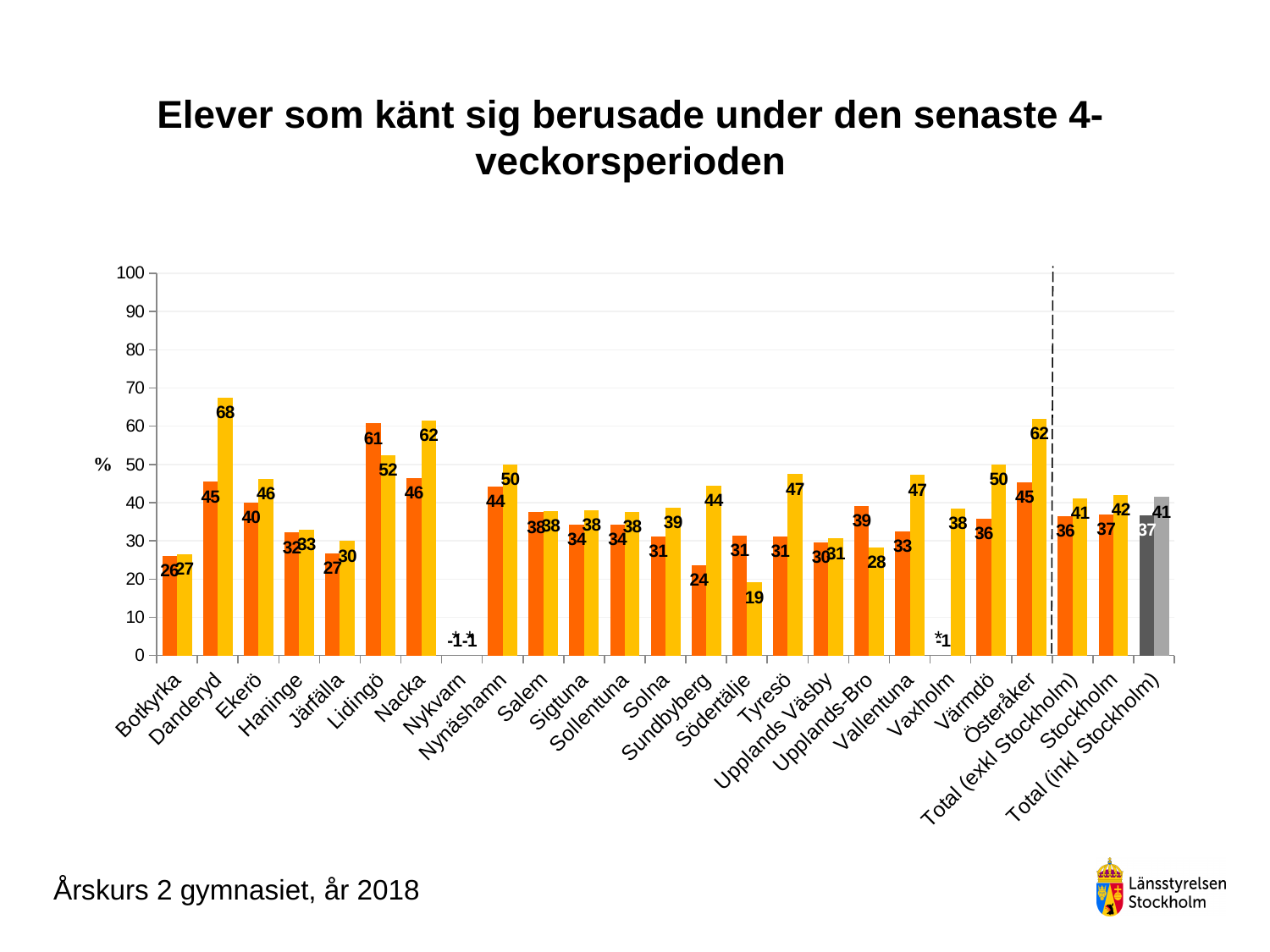
Which is larger for Upplands-Bro: the orange (left) bar or the yellow (right) bar? the orange (left) bar What is the value of the yellow (right) bar for Danderyd? 68 Which municipality has the highest orange (left) bar? Lidingö Is the value of the yellow (right) bar for Nacka greater or less than 50? greater What is the value of the yellow (right) bar for Stockholm? 42 Which municipality has the highest yellow (right) bar? Danderyd What is the value of the yellow (right) bar for Södertälje? 19 What is the title of the chart? Elever som känt sig berusade under den senaste 4-veckorsperioden What is the difference between the yellow (right) bar and the orange (left) bar for Sundbyberg? 20 What kind of chart is shown on the slide? bar chart What is the value of the orange (left) bar for Total (inkl Stockholm)? 37 What is the value of the orange (left) bar for Lidingö? 61